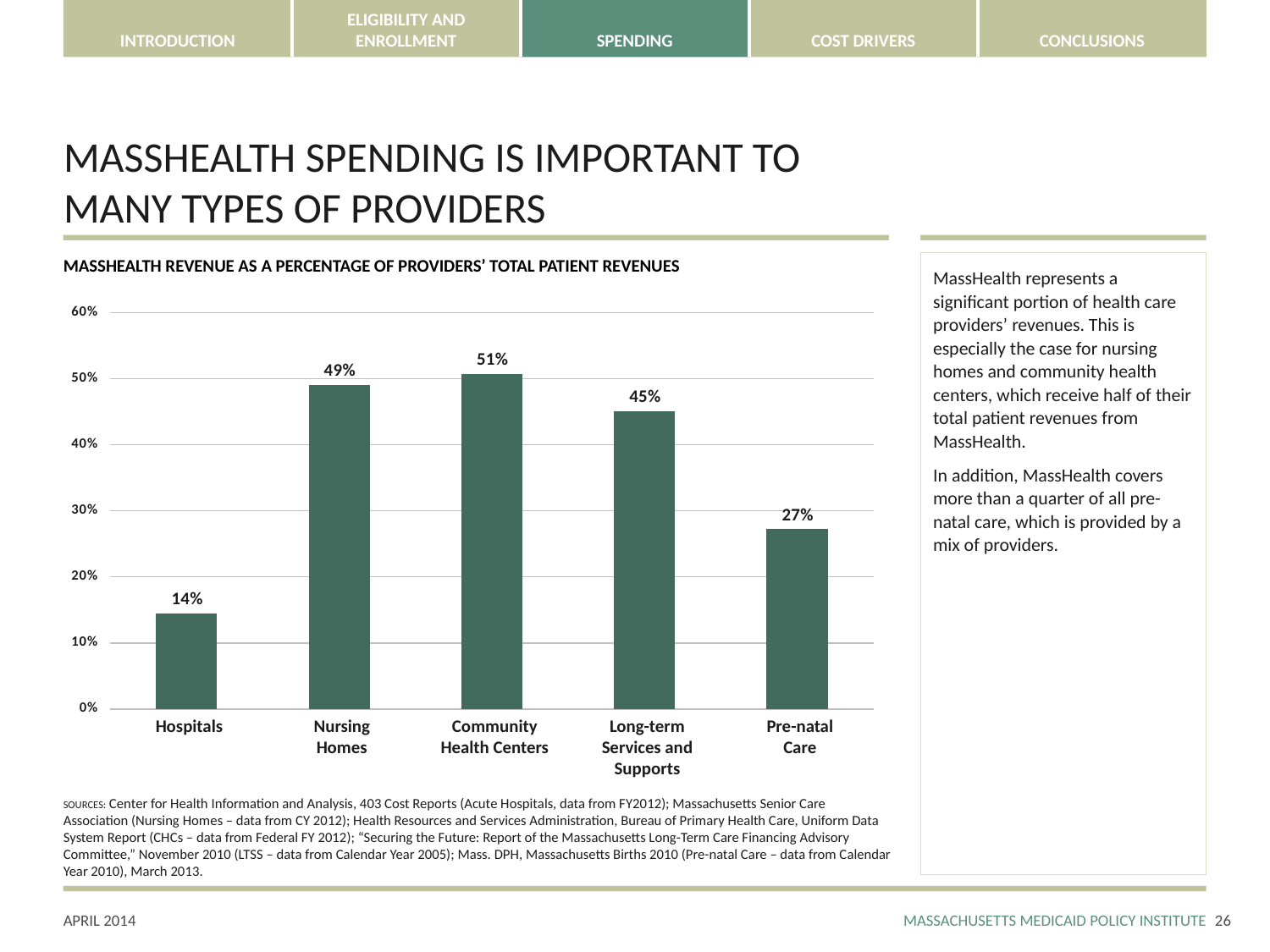
What type of chart is shown on the slide? bar chart How many provider categories are shown in the chart? 5 What is the value shown for Long-term Services and Supports? 45% Which is larger, the value for Long-term Services and Supports or the value for Nursing Homes? Nursing Homes Is the value for Hospitals greater or less than 20%? less What is the difference between the values for Community Health Centers and Hospitals? 37% Which provider type has the highest MassHealth revenue percentage? Community Health Centers Which provider type has the lowest MassHealth revenue percentage? Hospitals What is the value shown for Pre-natal Care? 27% What is the MassHealth revenue percentage for Nursing Homes? 49% What is the difference between the values for Nursing Homes and Pre-natal Care? 22% What is the title of the chart? MassHealth Revenue as a Percentage of Providers' Total Patient Revenues